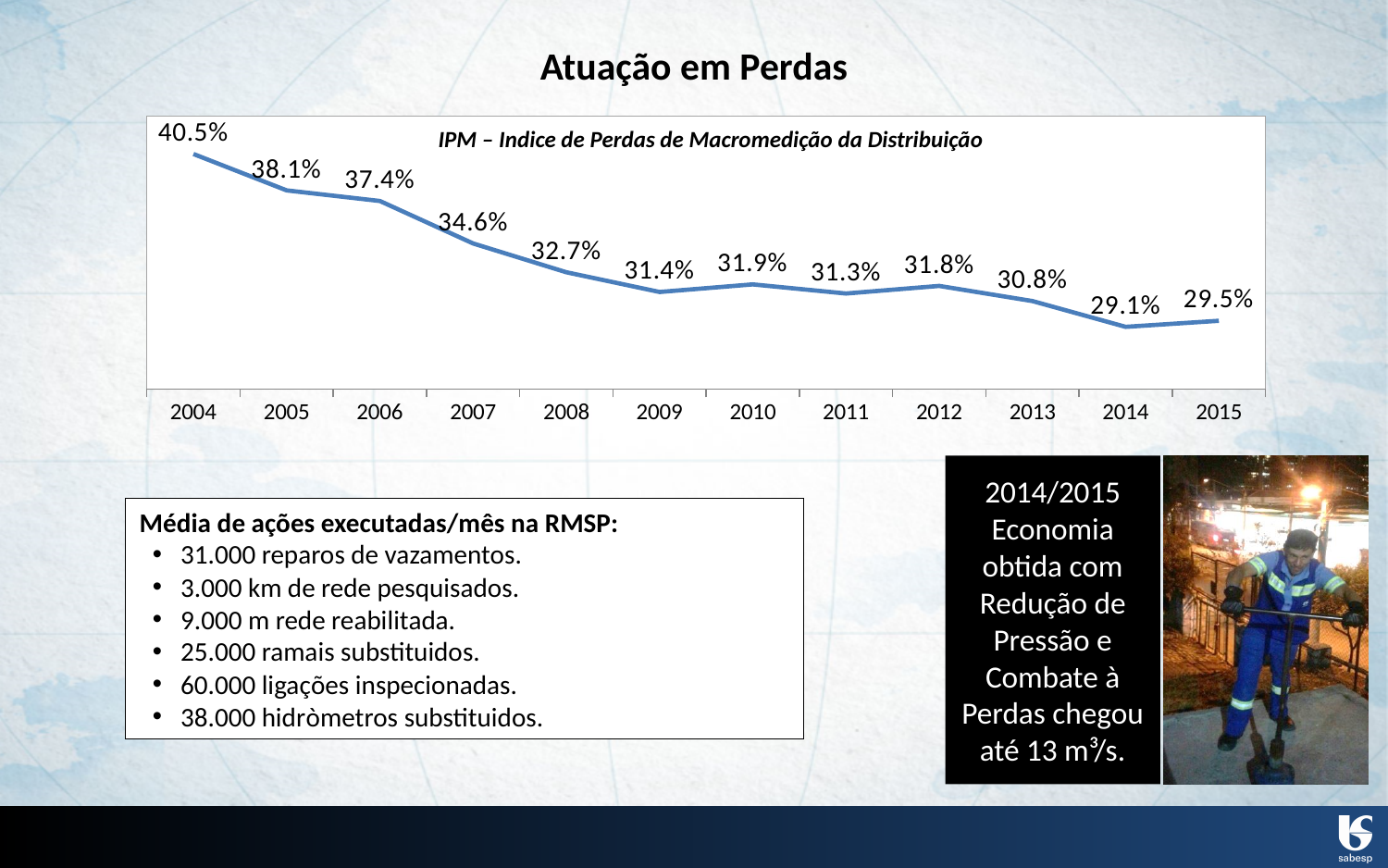
Which year has the lowest IPM value? 2014 What is the IPM value for 2015? 29.5% How many years are plotted on the chart? 12 Which year has the highest IPM value? 2004 What is the IPM value for 2009? 31.4% What is the title shown inside the chart? IPM – Indice de Perdas de Macromedição da Distribuição Does the IPM value generally rise or fall from 2004 to 2015? Fall What is the difference between the IPM values for 2014 and 2015? 0.4 percentage points What is the IPM value for 2004? 40.5% What is the difference between the IPM values for 2004 and 2015? 11 percentage points Which year has a higher IPM value, 2007 or 2013? 2007 What kind of chart is shown on the slide? Line chart